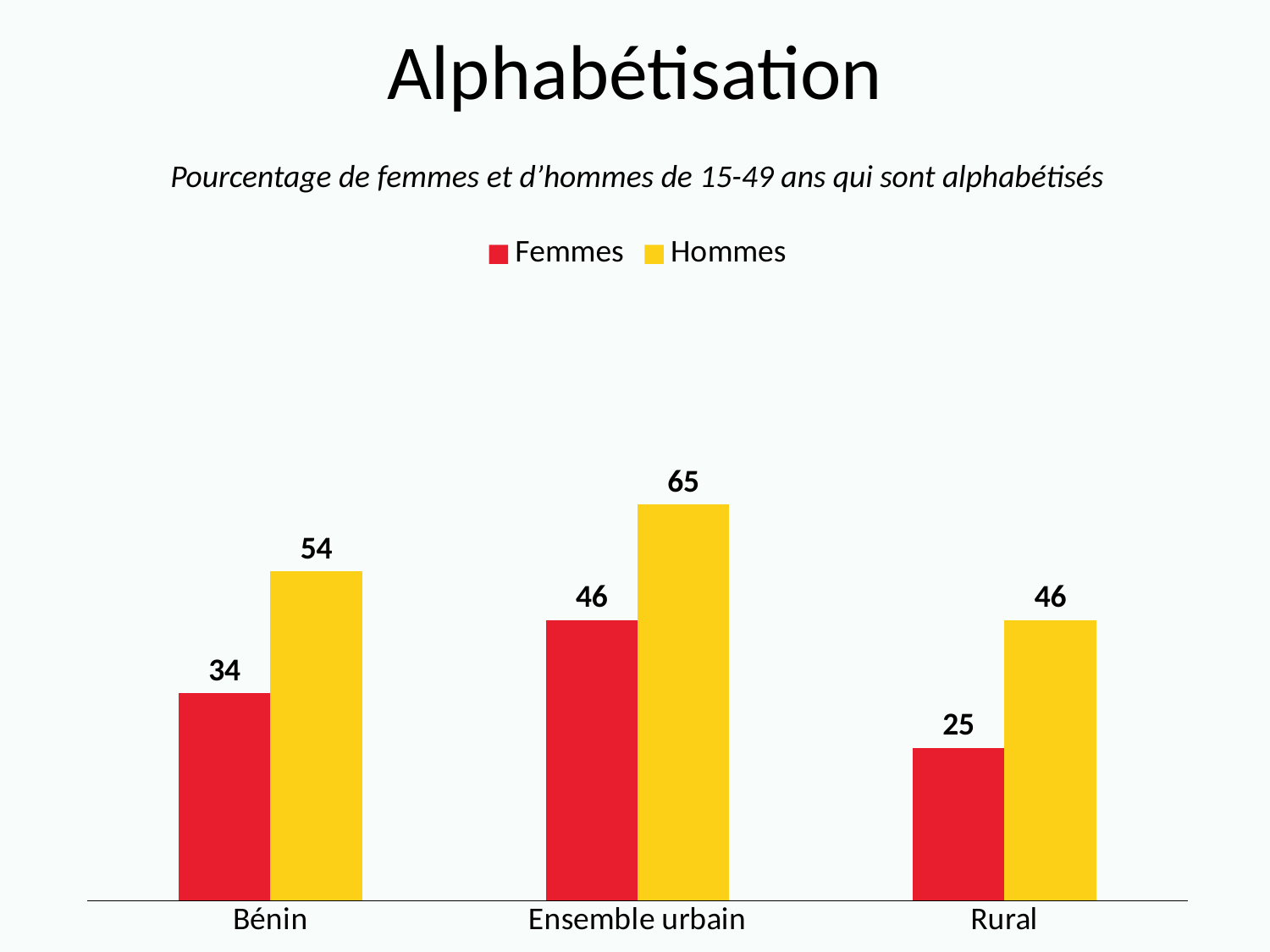
How many categories are shown on the x axis? 3 How many series does the legend list? 2 Which is larger: Femmes in Ensemble urbain or Hommes in Rural? They are equal (46) What is the value for Femmes in Bénin? 34 What kind of chart is shown on the slide? Bar chart What is the difference between Hommes and Femmes in Rural? 21 Which category has the lowest value for Femmes? Rural What is the value for Femmes in Rural? 25 What is the difference between Hommes and Femmes in Bénin? 20 Which category has the highest value for Hommes? Ensemble urbain What is the value for Hommes in Rural? 46 What is the value for Hommes in Ensemble urbain? 65